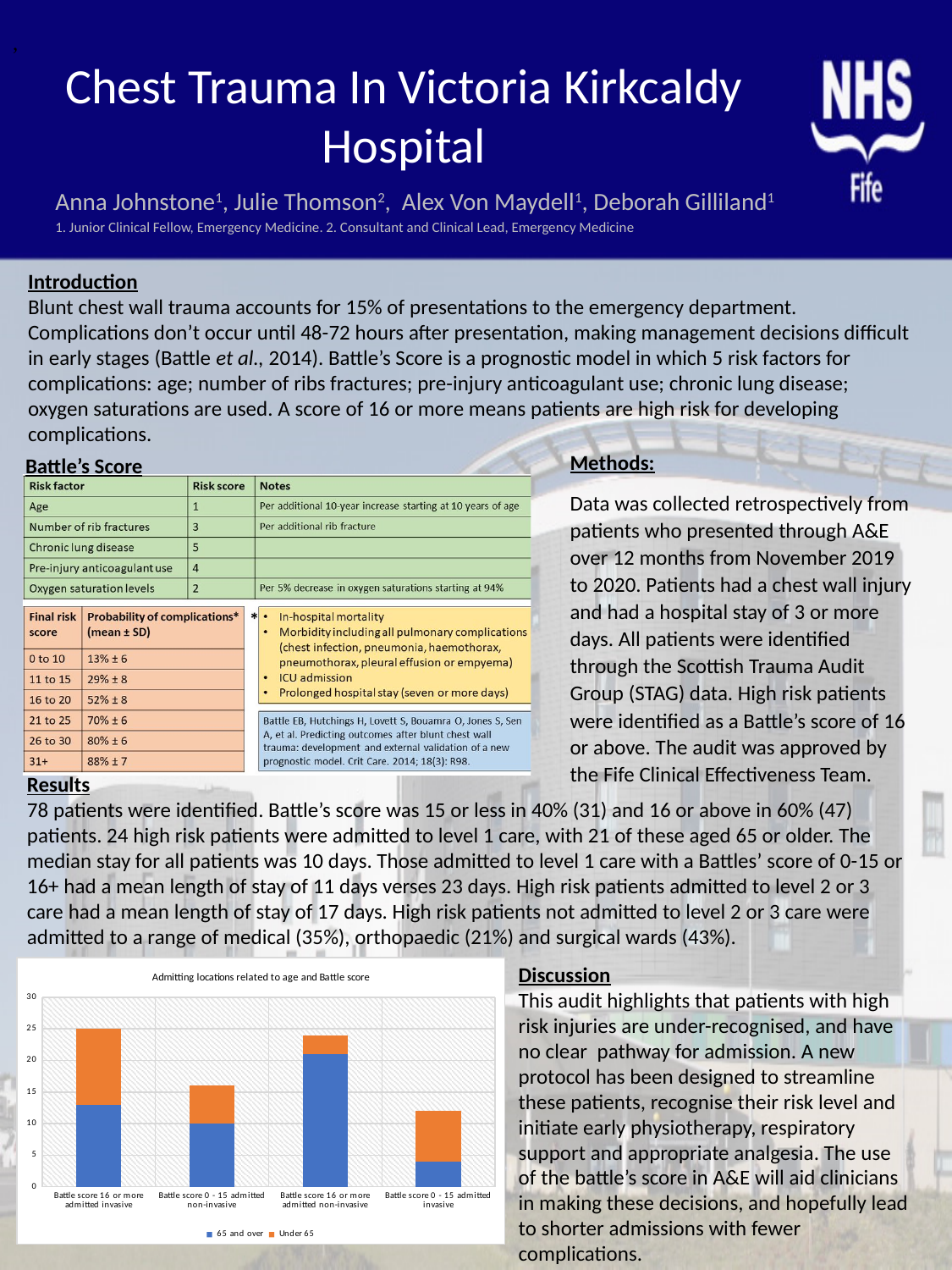
What is the title of the chart on the slide? Admitting locations related to age and Battle score Which category has the lowest total bar height? Battle score 0 - 15 admitted invasive How many categories are shown on the x axis of the chart? 4 Is the total bar height for 'Battle score 0 - 15 admitted non-invasive' greater or less than 20? less Which category has the largest '65 and over' segment? Battle score 16 or more admitted non-invasive Which category has the smallest '65 and over' segment? Battle score 0 - 15 admitted invasive Is the '65 and over' value for 'Battle score 16 or more admitted invasive' larger or smaller than the '65 and over' value for 'Battle score 0 - 15 admitted non-invasive'? larger How many series does the chart's legend list? 2 What kind of chart is shown on the slide? Stacked bar chart Which series is shown in orange in the chart? Under 65 Which category has the largest 'Under 65' segment? Battle score 16 or more admitted invasive Is the total bar height for 'Battle score 16 or more admitted invasive' greater or less than 20? greater